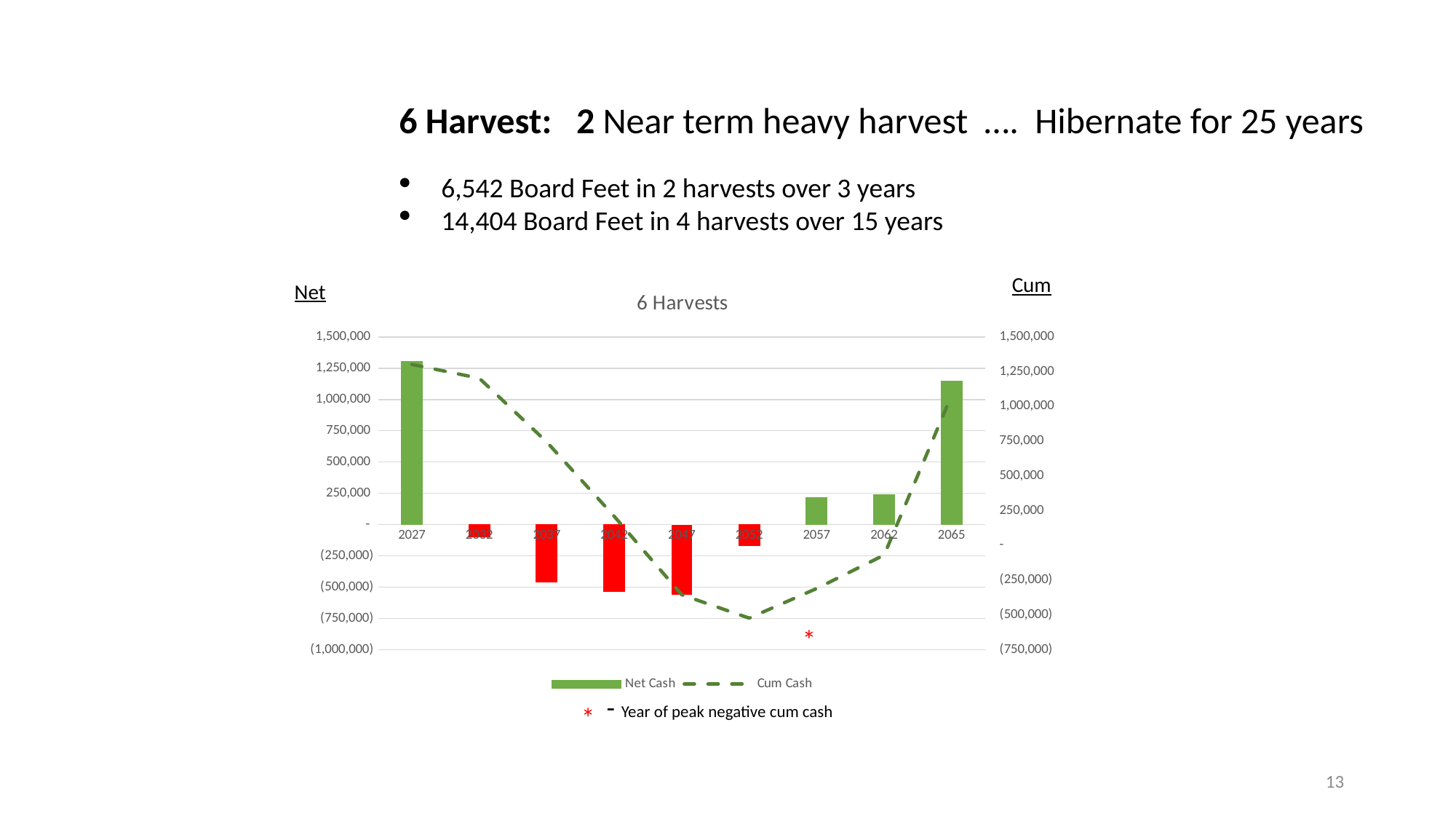
What is the title of the chart? 6 Harvests How many series does the chart legend list? 2 How many years are shown on the x axis of the chart? 9 Which is larger, the Net Cash bar for 2027 or for 2065? 2027 What are the two series named in the chart legend? Net Cash and Cum Cash Is the Net Cash value for 2037 greater or less than (250,000)? less Does the Cum Cash line rise or fall between 2027 and 2052? fall What kind of chart is shown on the slide? bar chart with a dashed line Is the Net Cash value for 2065 greater or less than 1,000,000? greater Is the Net Cash value for 2027 greater or less than 1,000,000? greater Which year has the highest Net Cash bar? 2027